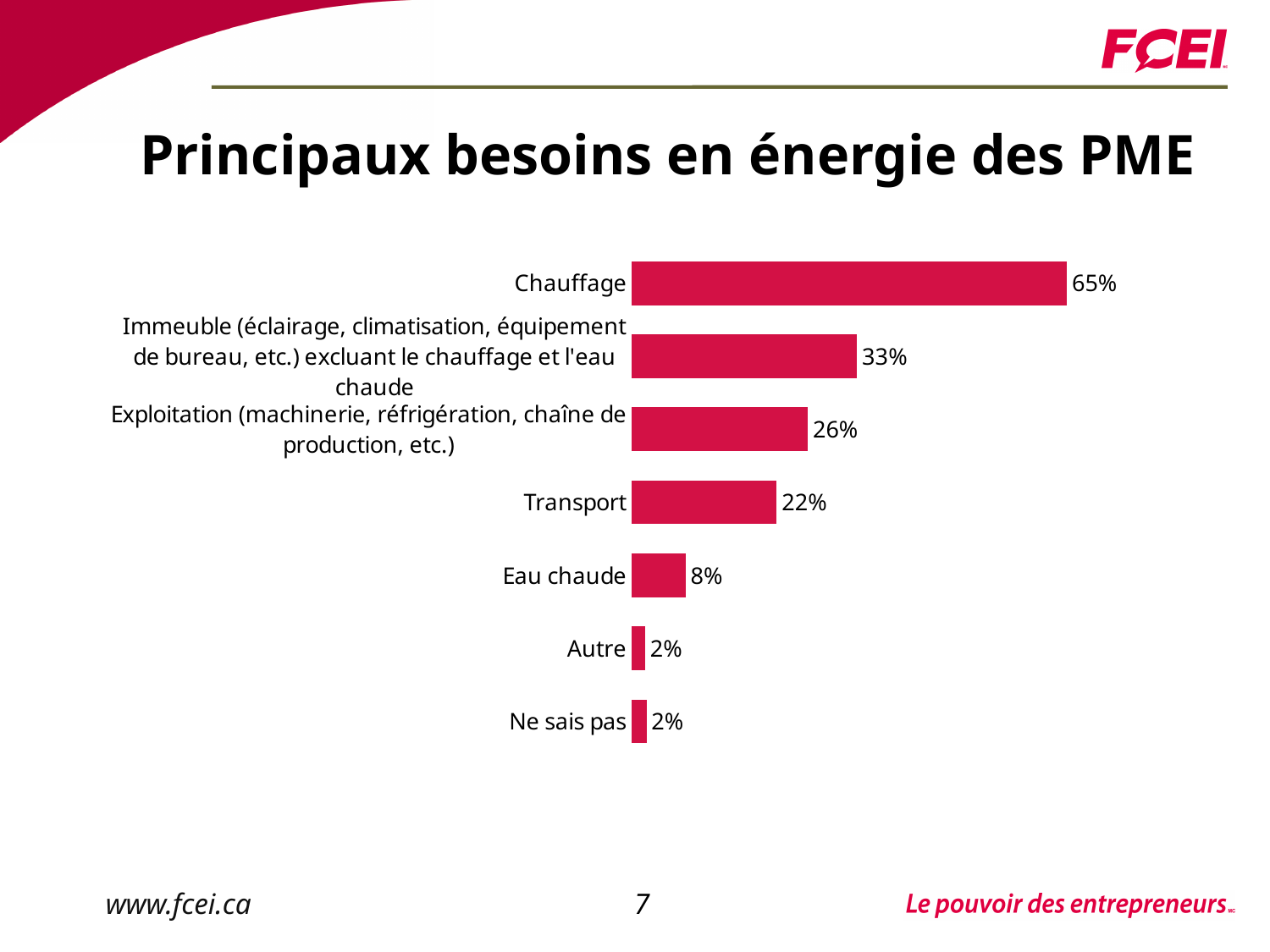
Which is larger, the value for Transport or the value for Eau chaude? Transport What is the value for Transport? 22% What is the value for Ne sais pas? 2% What is the value for Eau chaude? 8% Which category has the highest value? Chauffage How many categories are shown in the chart? 7 What is the difference between the values for Chauffage and Transport? 43% What is the value for Chauffage? 65% What kind of chart is shown on the slide? Bar chart What is the value for Exploitation (machinerie, réfrigération, chaîne de production, etc.)? 26% What is the difference between the values for Immeuble (éclairage, climatisation, équipement de bureau, etc.) excluant le chauffage et l'eau chaude and Exploitation (machinerie, réfrigération, chaîne de production, etc.)? 7% What is the title of the slide? Principaux besoins en énergie des PME